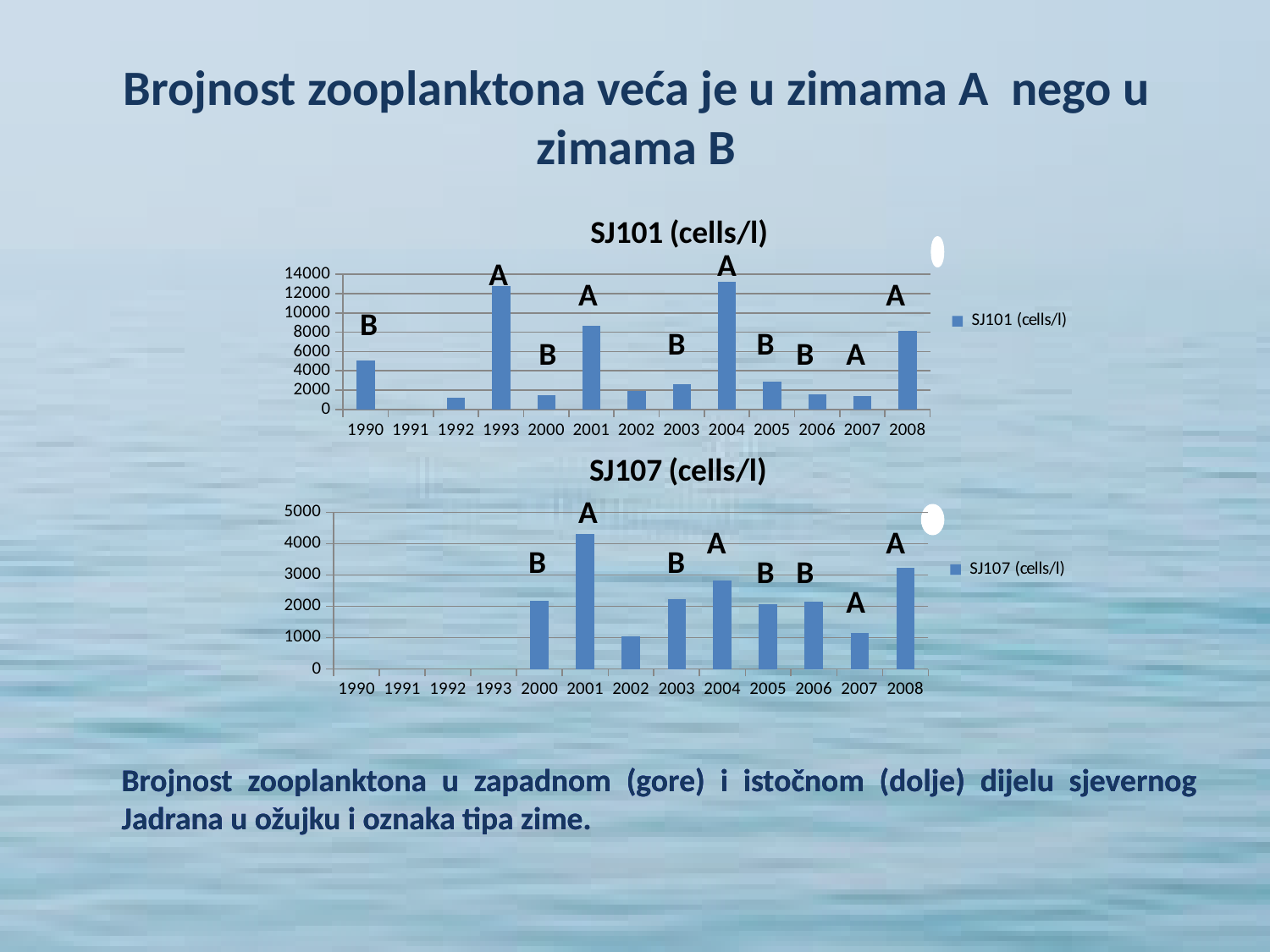
How many year categories are shown on the x axis of the SJ101 (cells/l) chart? 13 In the SJ101 (cells/l) chart, is the value for 1993 greater or less than 12000? greater In the SJ101 (cells/l) chart, which is larger, the value for 2004 or the value for 2005? 2004 What type of chart is the SJ101 (cells/l) chart? bar chart In the SJ101 (cells/l) chart, is the value for 1990 greater or less than 6000? less What is the title of the lower chart on the slide? SJ107 (cells/l) In the SJ107 (cells/l) chart, which year has the highest value? 2001 How many series does the legend of the SJ107 (cells/l) chart list? 1 In the SJ107 (cells/l) chart, which is larger, the value for 2004 or the value for 2007? 2004 In the SJ107 (cells/l) chart, is the value for 2008 greater or less than 3000? greater